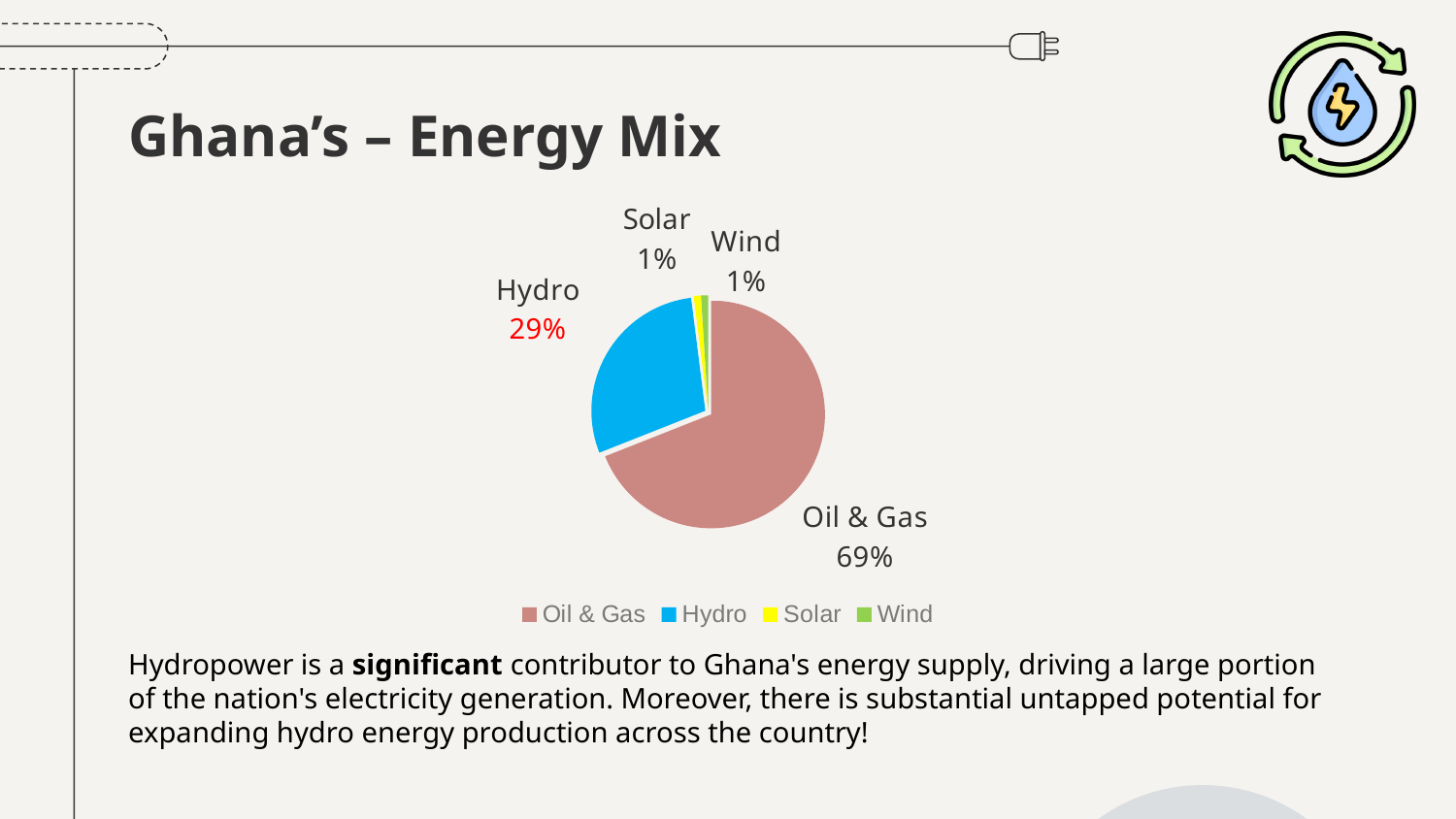
How many entries does the legend list? 4 What is the title of the slide containing the chart? Ghana's – Energy Mix What share of the pie does Hydro represent? 29% What is the value shown for Solar? 1% Which is larger, the Hydro share or the Oil & Gas share? Oil & Gas What kind of chart is shown on the slide? Pie chart What share of the pie does Oil & Gas represent? 69% What is the value shown for Wind? 1% What is the difference between the Oil & Gas share and the Hydro share? 40% Which category has the largest share of the pie? Oil & Gas What colour is the Hydro slice in the pie chart? Blue How many categories are shown in the pie chart? 4